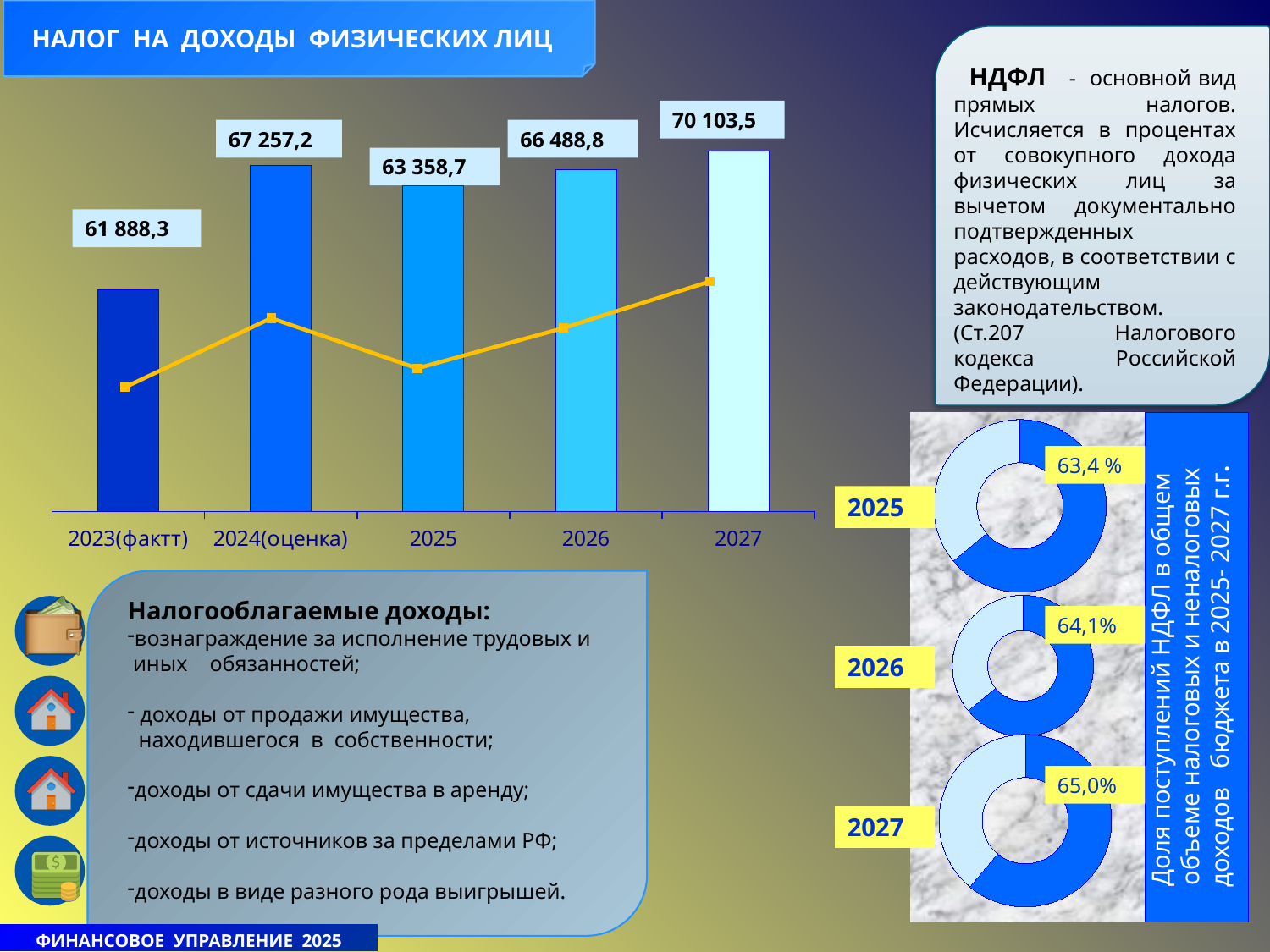
In the donut charts on the right, do the НДФЛ shares rise or fall from 2025 to 2027? Rise In the bar chart 'НАЛОГ НА ДОХОДЫ ФИЗИЧЕСКИХ ЛИЦ', which year has the highest value? 2027 What kind of chart is the large chart at the top left of the slide? Bar chart with a line overlay In the bar chart 'НАЛОГ НА ДОХОДЫ ФИЗИЧЕСКИХ ЛИЦ', what is the value for 2023(факт)? 61 888,3 How many years (categories) are shown in the bar chart 'НАЛОГ НА ДОХОДЫ ФИЗИЧЕСКИХ ЛИЦ'? 5 In the bar chart 'НАЛОГ НА ДОХОДЫ ФИЗИЧЕСКИХ ЛИЦ', what is the difference between the 2027 value and the 2023(факт) value? 8 215,2 In the bar chart 'НАЛОГ НА ДОХОДЫ ФИЗИЧЕСКИХ ЛИЦ', which year has the lowest value? 2023(факт) In the bar chart 'НАЛОГ НА ДОХОДЫ ФИЗИЧЕСКИХ ЛИЦ', what is the value for 2027? 70 103,5 In the bar chart 'НАЛОГ НА ДОХОДЫ ФИЗИЧЕСКИХ ЛИЦ', which is larger: the value for 2024(оценка) or the value for 2026? 2024(оценка) In the bar chart 'НАЛОГ НА ДОХОДЫ ФИЗИЧЕСКИХ ЛИЦ', what is the value for 2025? 63 358,7 In the donut charts on the right, what is the share of НДФЛ for 2027? 65,0% In the donut charts on the right, what is the share of НДФЛ for 2025? 63,4 %